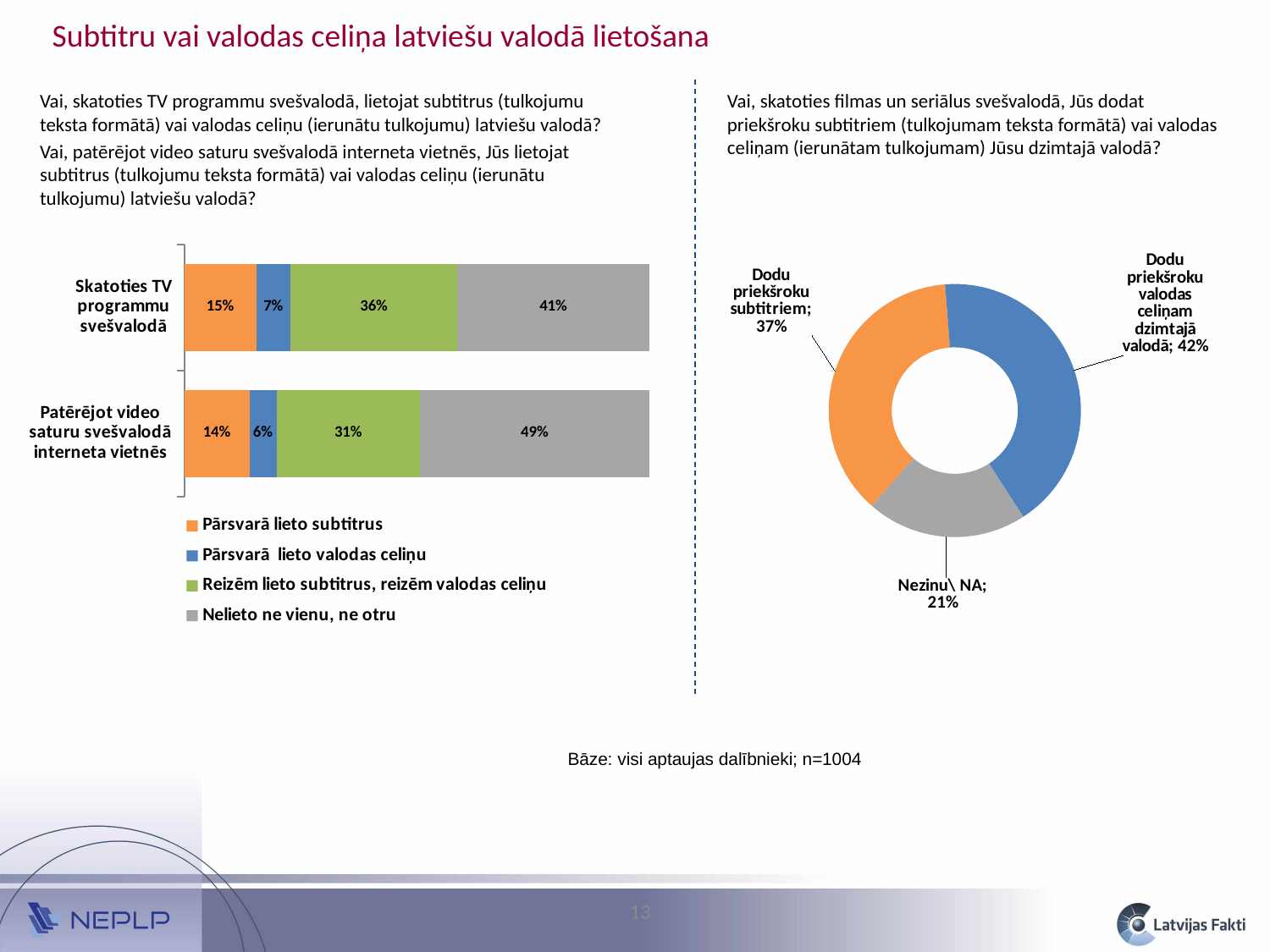
In the bar chart on the left, what is the value for 'Reizēm lieto subtitrus, reizēm valodas celiņu' for 'Skatoties TV programmu svešvalodā'? 36% How many series does the legend of the bar chart on the left list? 4 In the doughnut chart on the right, what is the difference between the 'Dodu priekšroku valodas celiņam dzimtajā valodā' and 'Dodu priekšroku subtitriem' shares? 5 percentage points In the bar chart on the left, which segment is the largest in the 'Patērējot video saturu svešvalodā interneta vietnēs' bar? Nelieto ne vienu, ne otru In the bar chart on the left, what is the difference between the 'Nelieto ne vienu, ne otru' values for the two bars? 8 percentage points In the bar chart on the left, which bar has the higher value for 'Pārsvarā lieto subtitrus'? Skatoties TV programmu svešvalodā In the bar chart on the left, what percentage of respondents 'Pārsvarā lieto subtitrus' when 'Skatoties TV programmu svešvalodā'? 15% In the bar chart on the left, which segment is the smallest in the 'Skatoties TV programmu svešvalodā' bar? Pārsvarā lieto valodas celiņu In the bar chart on the left, what is the value for 'Nelieto ne vienu, ne otru' in the 'Patērējot video saturu svešvalodā interneta vietnēs' bar? 49% In the doughnut chart on the right, which answer has the smallest share? Nezinu\ NA What type of chart is shown on the left side of the slide? Stacked bar chart In the doughnut chart on the right, what share of respondents answered 'Dodu priekšroku valodas celiņam dzimtajā valodā'? 42%